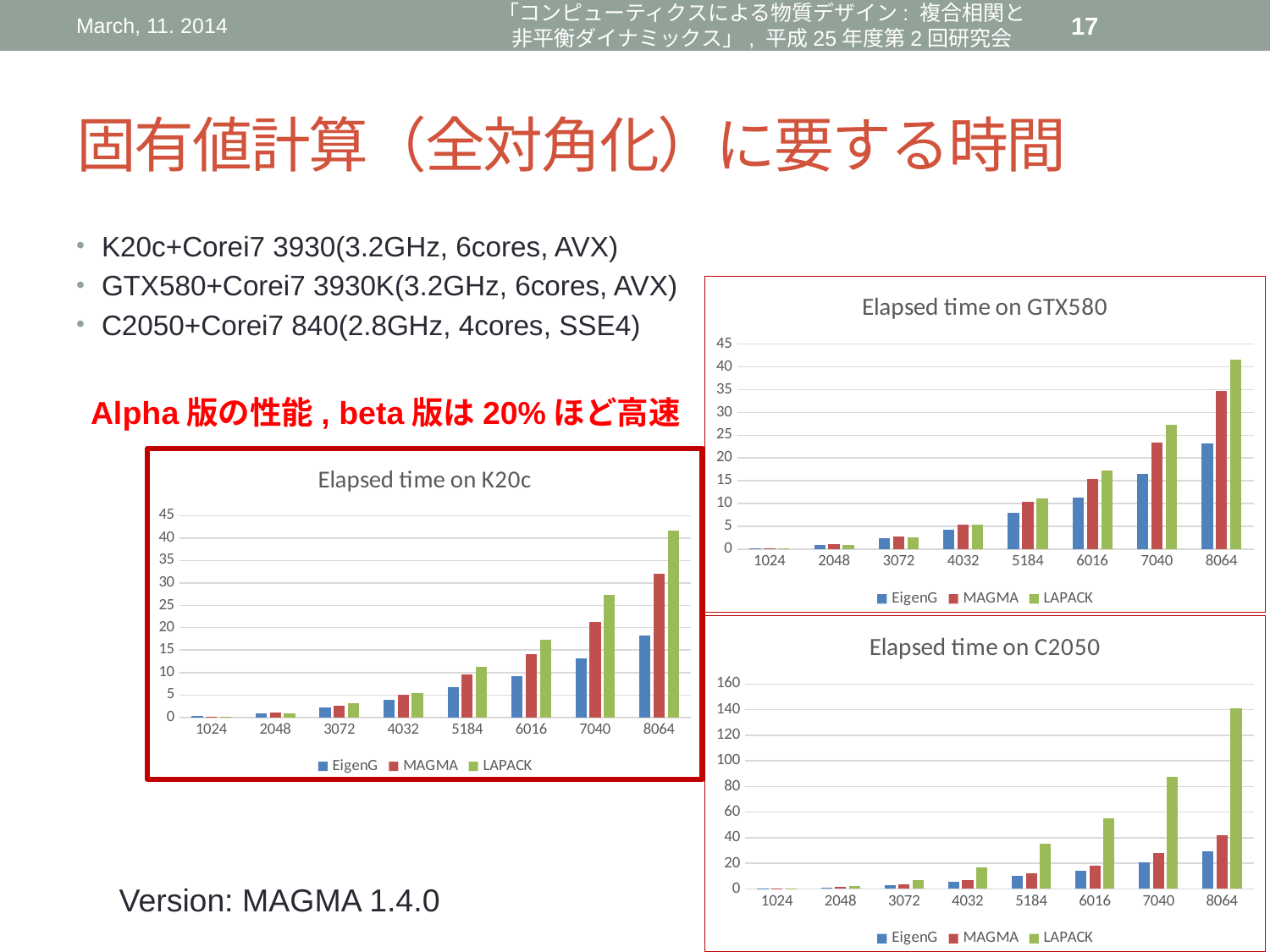
In the "Elapsed time on GTX580" chart, is the MAGMA value at 8064 greater or less than 30? greater In the "Elapsed time on C2050" chart, do the LAPACK values rise or fall as the matrix size increases along the x axis? rise In the "Elapsed time on C2050" chart, is the LAPACK value at 8064 greater or less than 120? greater How many series does the legend of the "Elapsed time on GTX580" chart list? 3 In the "Elapsed time on K20c" chart, is the EigenG value at 8064 greater or less than 20? less In the "Elapsed time on K20c" chart, which series has the tallest bar at 8064? LAPACK Which series is shown in green in the legend of the "Elapsed time on K20c" chart? LAPACK How many matrix-size categories are shown on the x axis of the "Elapsed time on C2050" chart? 8 In the "Elapsed time on GTX580" chart, which is larger at 7040: the EigenG bar or the LAPACK bar? LAPACK What type of chart is "Elapsed time on K20c"? bar chart